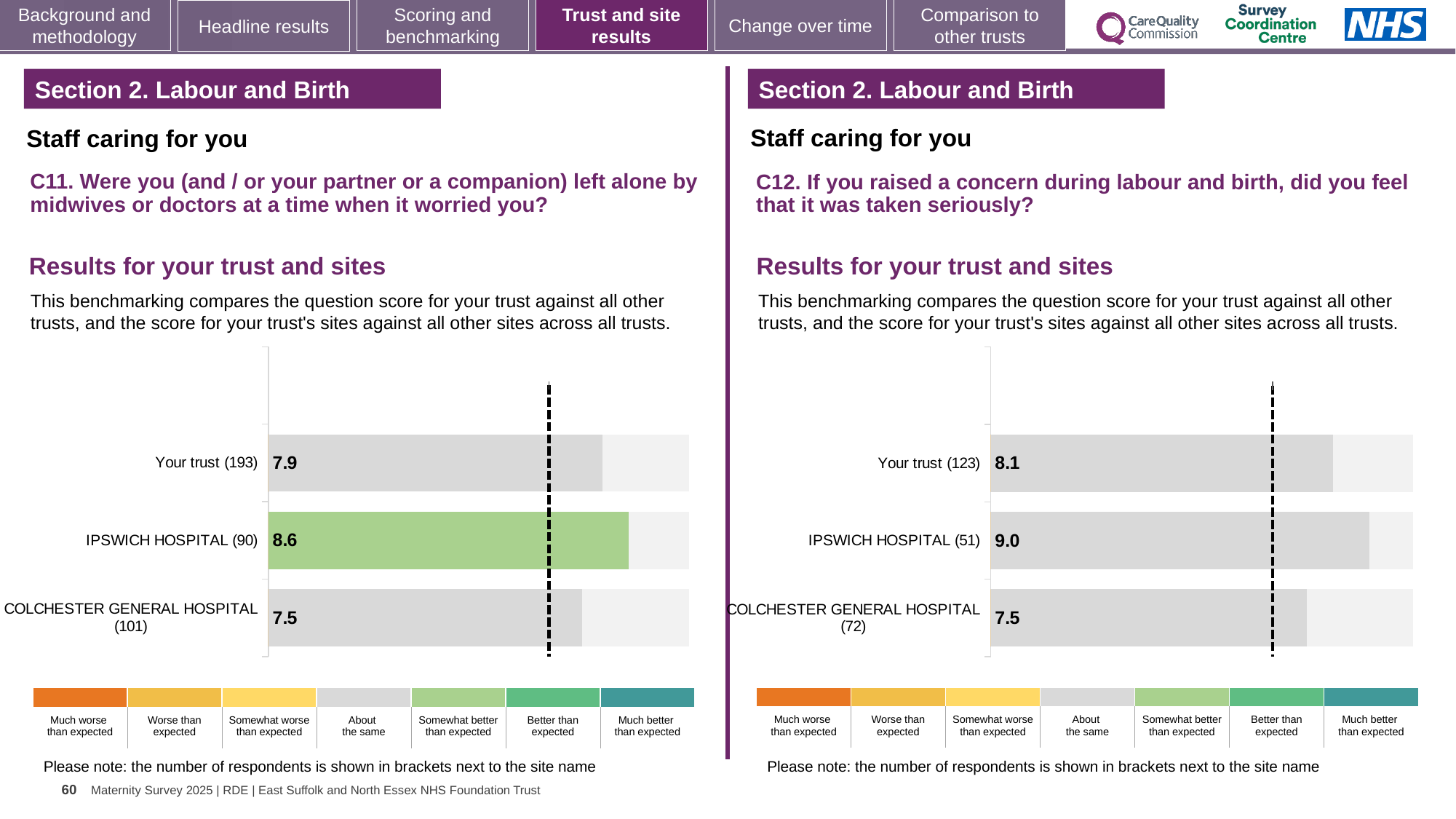
In the C11 chart on the left, which site or trust has the highest score? IPSWICH HOSPITAL In the C11 chart on the left, what is the difference between the IPSWICH HOSPITAL score and the COLCHESTER GENERAL HOSPITAL score? 1.1 In the C12 chart on the right, which site or trust has the lowest score? COLCHESTER GENERAL HOSPITAL How many bars are plotted in the C11 chart on the left? 3 In the C12 chart on the right, what is the score for IPSWICH HOSPITAL? 9.0 In the C11 chart on the left, what is the score for Your trust? 7.9 In the C11 chart on the left, what is the score for IPSWICH HOSPITAL? 8.6 In the C12 chart on the right, which has the larger score: Your trust or COLCHESTER GENERAL HOSPITAL? Your trust In the C12 chart on the right, what is the difference between the IPSWICH HOSPITAL score and the Your trust score? 0.9 What type of chart is used in the C12 chart on the right? Bar chart In the C12 chart on the right, what is the score for COLCHESTER GENERAL HOSPITAL? 7.5 In the C11 chart on the left, how many respondents are shown in brackets for COLCHESTER GENERAL HOSPITAL? 101